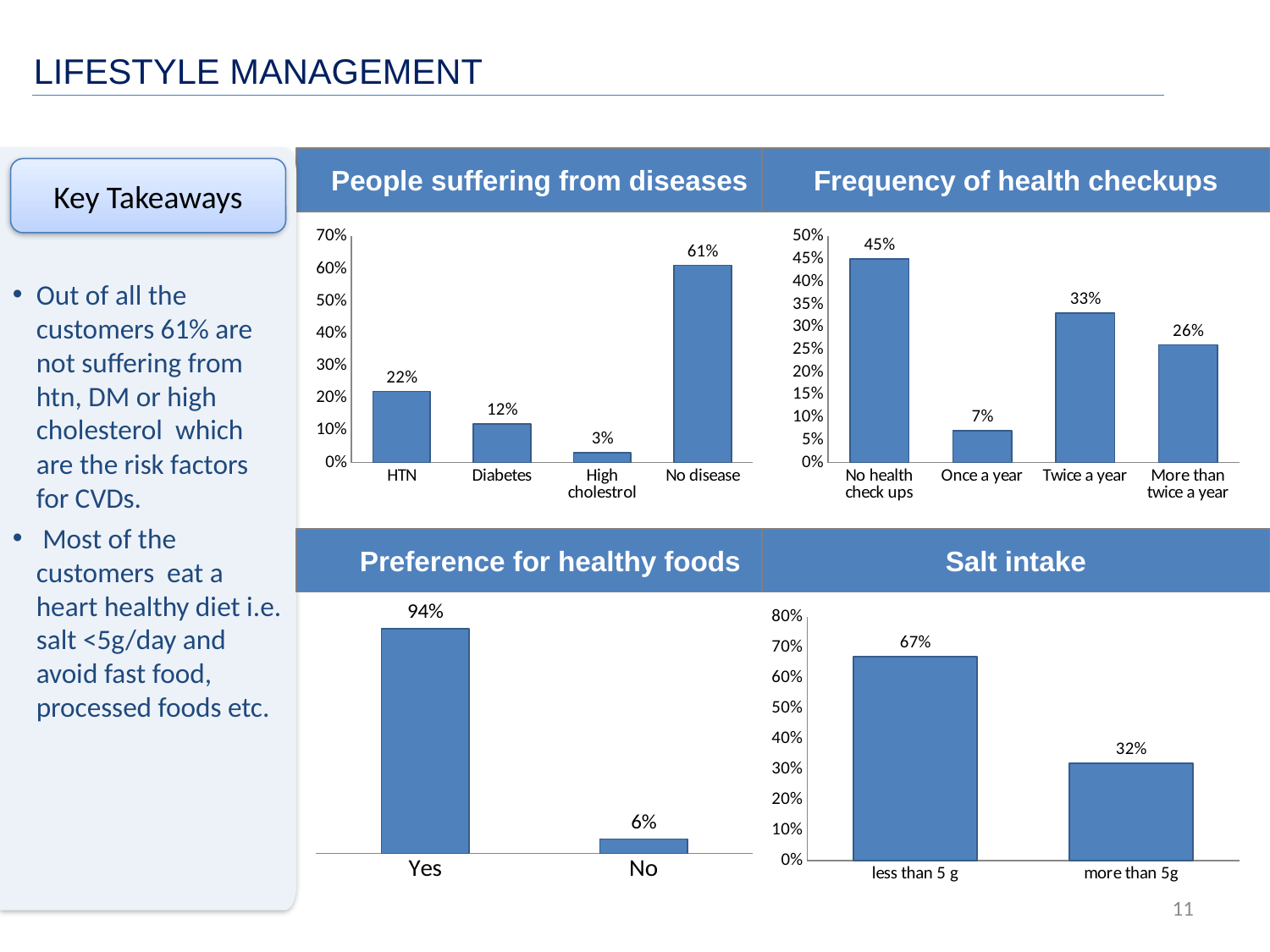
In the 'Salt intake' chart, what is the difference between the values for less than 5 g and more than 5g? 35% In the 'Frequency of health checkups' chart, what is the value for Twice a year? 33% In the 'People suffering from diseases' chart, what is the difference between the values for HTN and Diabetes? 10% In the 'Salt intake' chart, is the value for more than 5g greater or less than 40%? less In the 'People suffering from diseases' chart, which category has the lowest value? High cholestrol What kind of chart is the 'Salt intake' chart? Bar chart In the 'Frequency of health checkups' chart, which is larger: the value for No health check ups or the value for More than twice a year? No health check ups In the 'Preference for healthy foods' chart, what is the value for Yes? 94% In the 'Frequency of health checkups' chart, which category has the lowest value? Once a year In the 'People suffering from diseases' chart, which category has the highest value? No disease In the 'Frequency of health checkups' chart, how many categories are shown? 4 In the 'People suffering from diseases' chart, what is the value for Diabetes? 12%